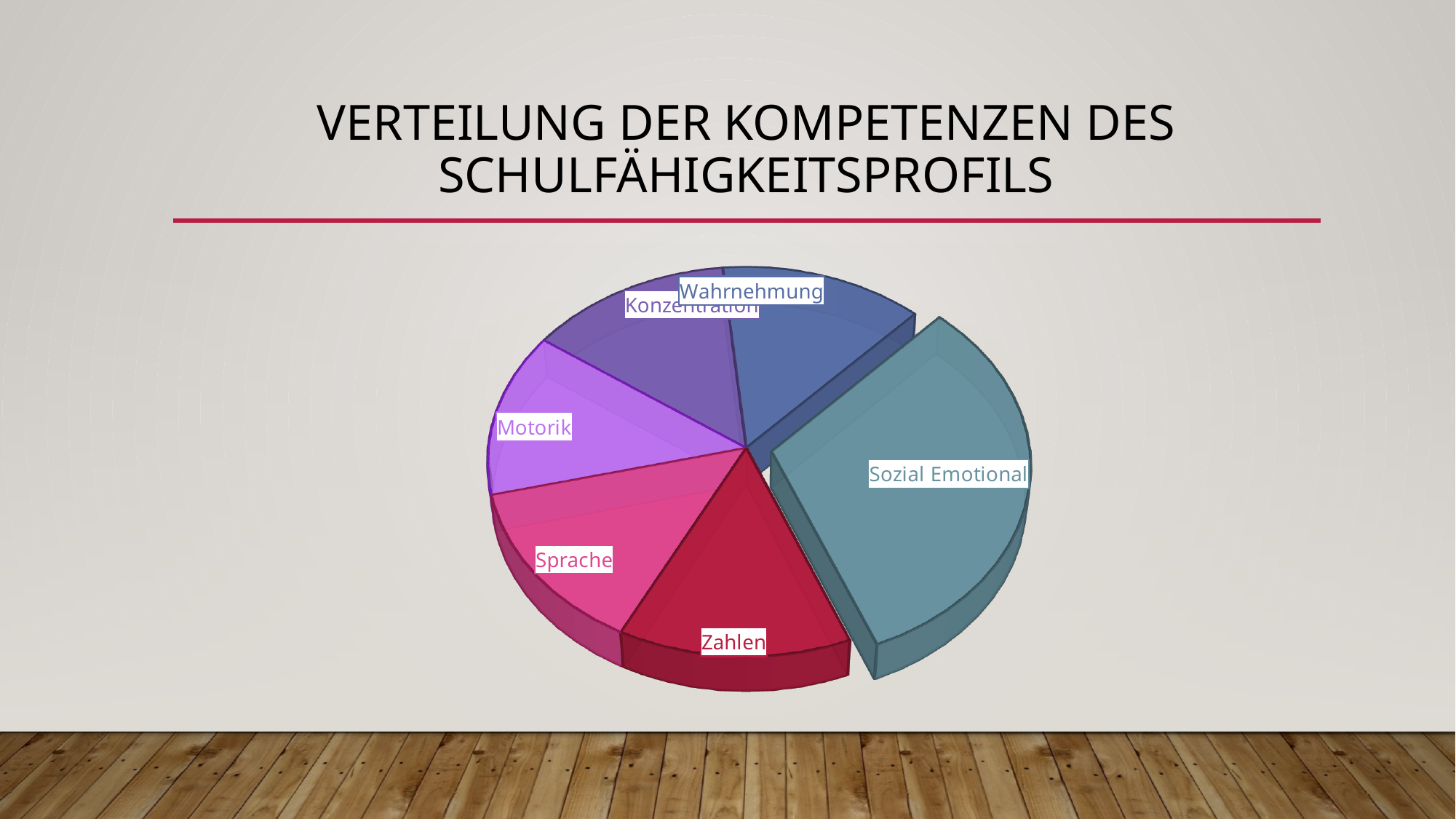
Which slice is larger, Sozial Emotional or Sprache? Sozial Emotional Which slice is larger, Sozial Emotional or Motorik? Sozial Emotional How many slices does the pie chart have? 6 Which category has the largest slice in the pie chart? Sozial Emotional Which slice is pulled out (exploded) from the rest of the pie chart? Sozial Emotional What is the title of the slide containing the pie chart? Verteilung der Kompetenzen des Schulfähigkeitsprofils What kind of chart is shown on the slide? pie chart